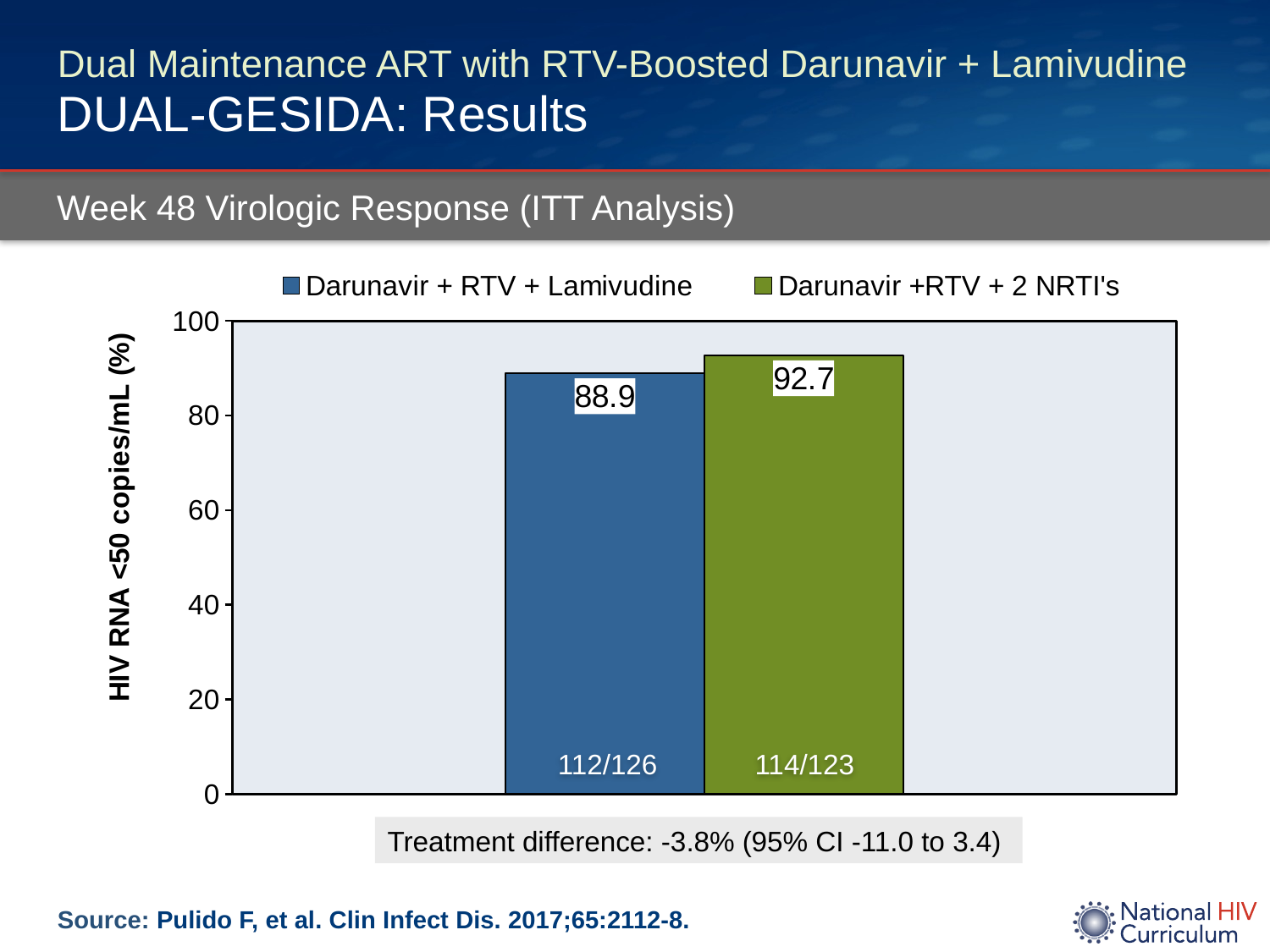
Which series has the lower value? Darunavir + RTV + Lamivudine Is the value for Darunavir + RTV + Lamivudine greater or less than 80? greater What kind of chart is shown? bar chart What is the y-axis label of the chart? HIV RNA <50 copies/mL (%) What is the difference between the values for Darunavir +RTV + 2 NRTI's and Darunavir + RTV + Lamivudine? 3.8 Is the value for Darunavir + RTV + Lamivudine larger or smaller than the value for Darunavir +RTV + 2 NRTI's? smaller What is the value for Darunavir +RTV + 2 NRTI's? 92.7 What fraction is printed inside the Darunavir + RTV + Lamivudine bar? 112/126 How many series does the legend list? 2 What is the value for Darunavir + RTV + Lamivudine? 88.9 Which series has the higher value? Darunavir +RTV + 2 NRTI's How many bars are plotted in the chart? 2